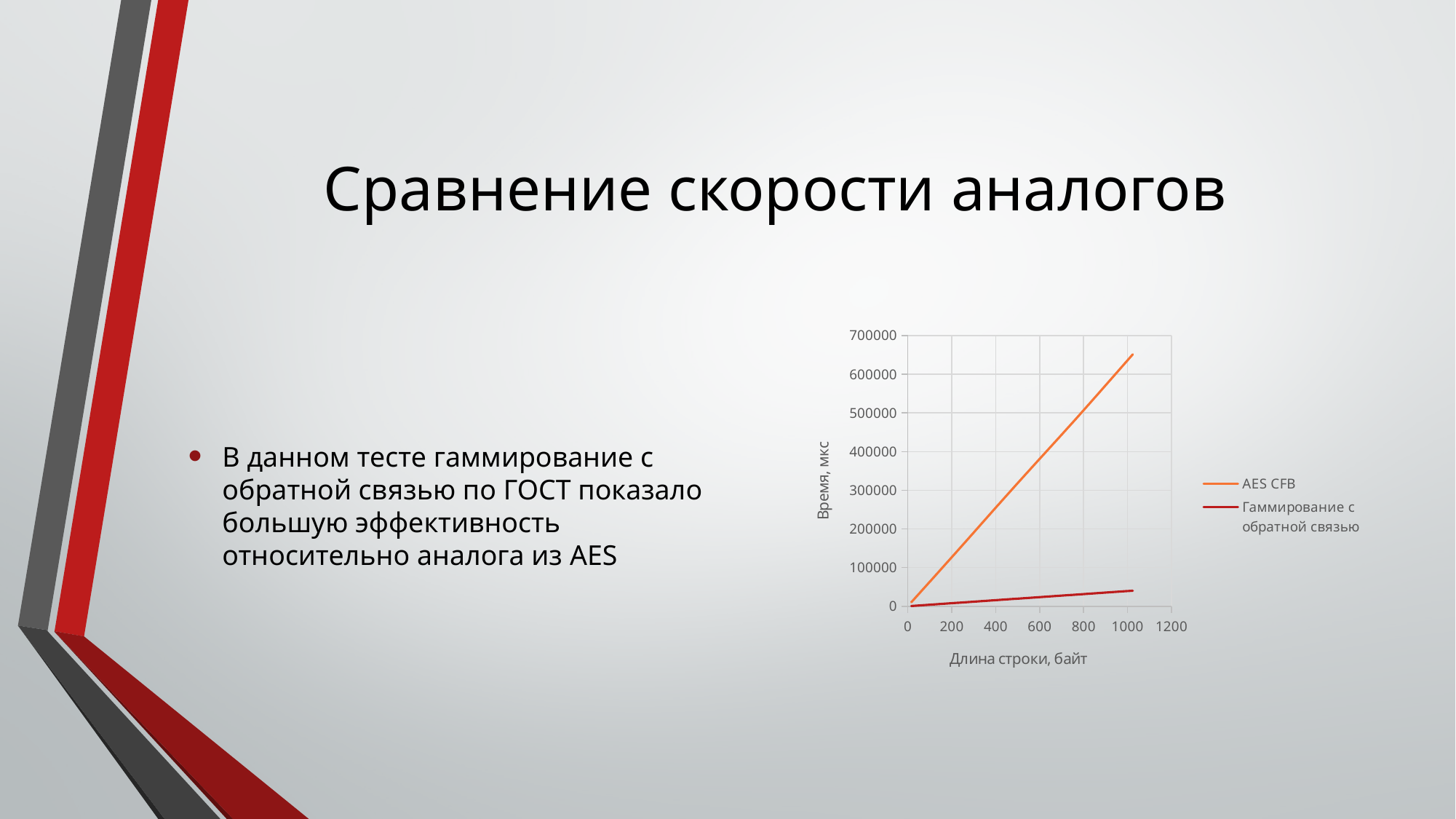
Which series has the lower time values across the chart? Гаммирование с обратной связью How many series does the chart legend list? 2 Which series has the higher time value at a string length of about 1000 bytes? AES CFB What are the two series named in the chart legend? AES CFB; Гаммирование с обратной связью Does the time for AES CFB rise or fall as string length increases? rise What is the title of the chart's x axis? Длина строки, байт Is the value for AES CFB at a string length of 600 bytes greater or less than 300000? greater What kind of chart is shown on the slide? line chart What is the highest tick value shown on the chart's y axis? 700000 Does the time for Гаммирование с обратной связью rise or fall as string length increases? rise Is the value for Гаммирование с обратной связью at its right-most point greater or less than 100000? less Is the value for AES CFB at its right-most point greater or less than 600000? greater